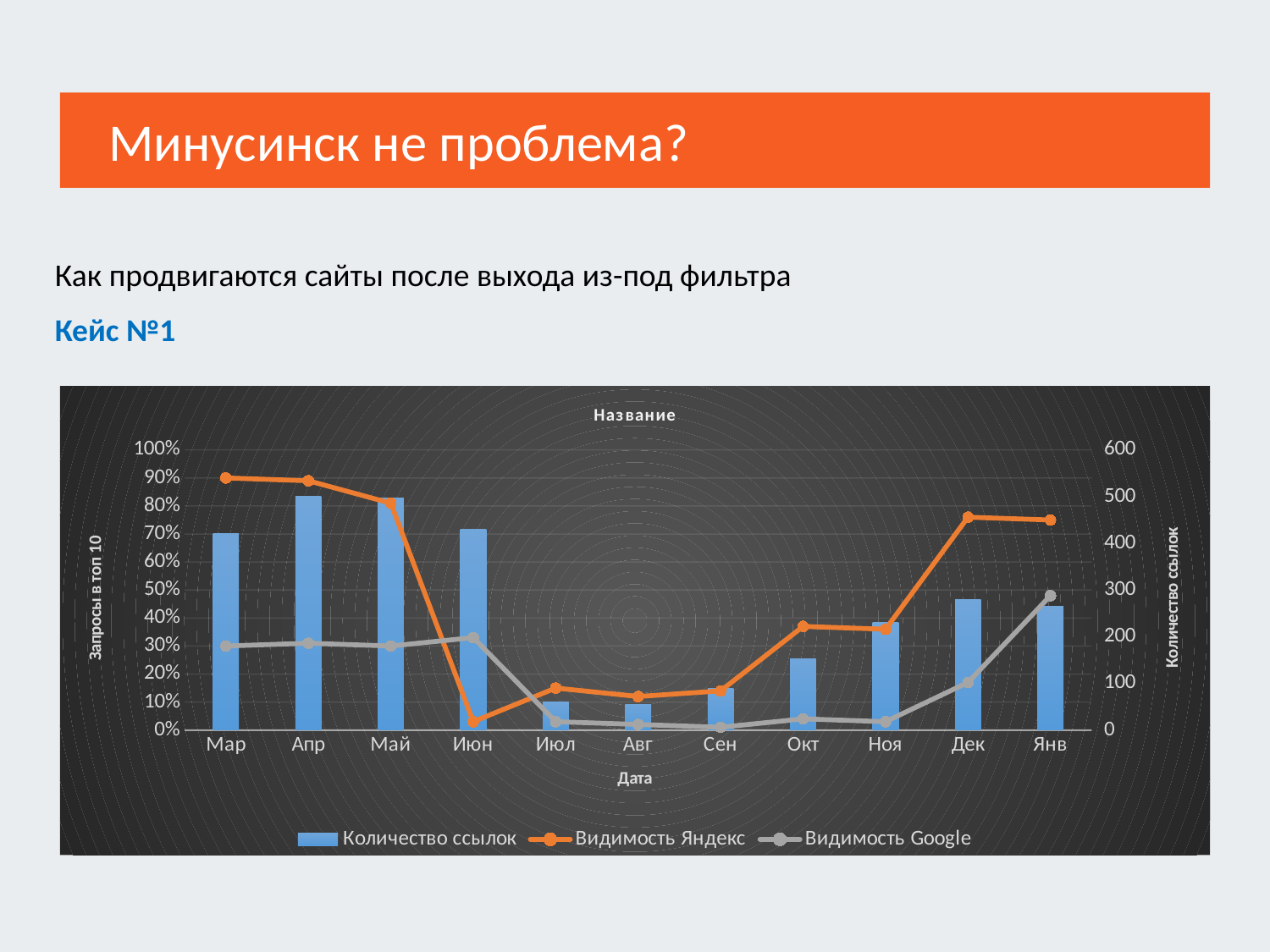
Which is larger: the Видимость Яндекс value for Дек or for Окт? Дек Is the Видимость Яндекс value for Мар greater or less than 80%? greater In which month is the Видимость Яндекс line at its lowest? Июн What is the label of the left vertical axis of the chart? Запросы в топ 10 Which series is drawn as bars in the chart? Количество ссылок How many months are shown along the x axis of the chart? 11 In which month is the Количество ссылок bar the lowest? Авг Does the Видимость Яндекс line rise or fall from Сен to Дек? rise In which month is the Видимость Google line at its highest? Янв What kind of chart is shown on the slide? A combined bar and line chart How many series does the chart legend list? 3 Is the Видимость Яндекс value for Июн greater or less than 10%? less